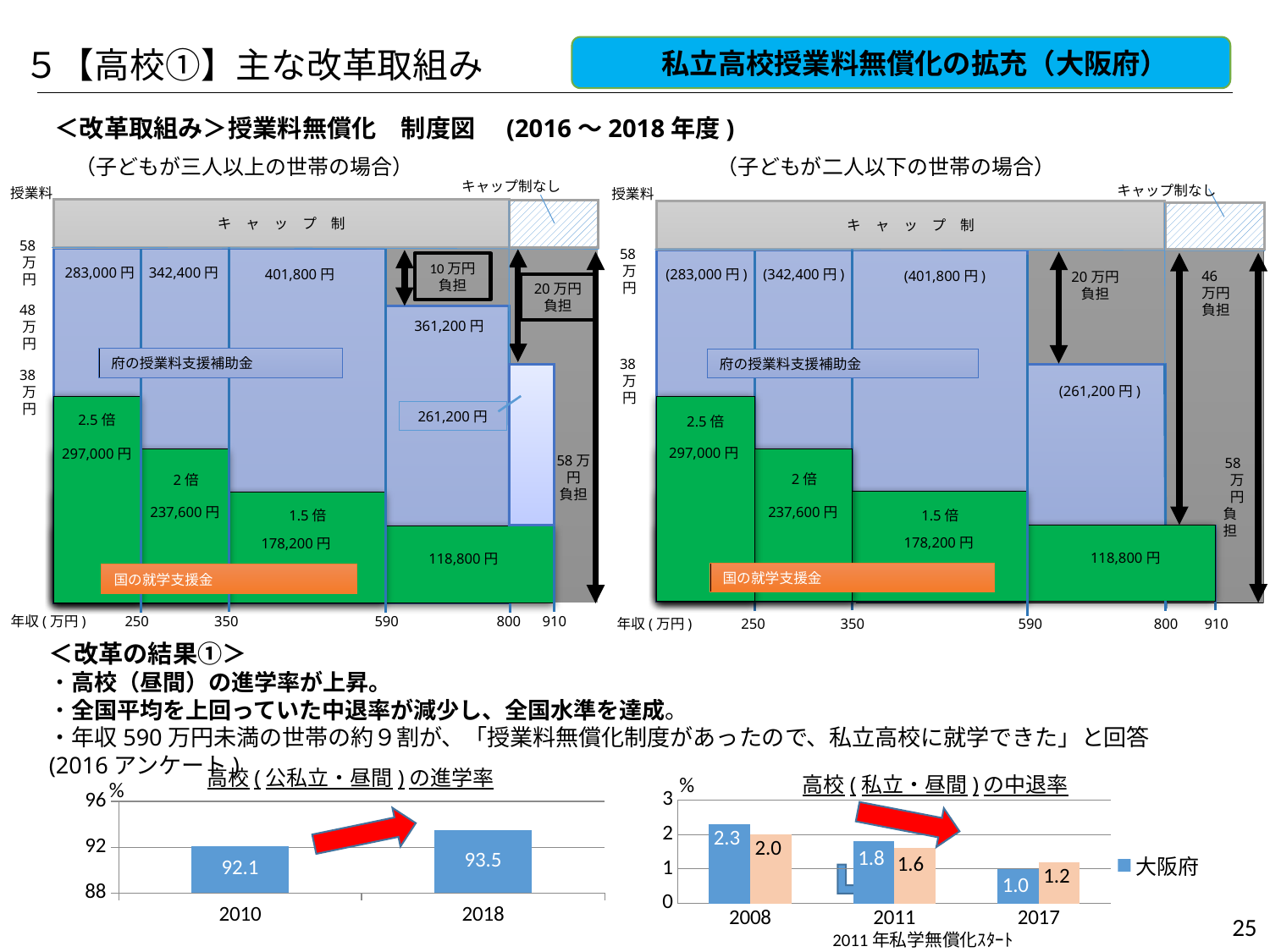
In the 高校(公私立・昼間)の進学率 chart, what is the difference between the 2018 and 2010 values? 1.4 What kind of chart is the 高校(私立・昼間)の中退率 chart? bar chart In the 高校(公私立・昼間)の進学率 chart, what is the value for 2010? 92.1 In the 高校(私立・昼間)の中退率 chart, what is the 大阪府 value for 2008? 2.3 In the 高校(公私立・昼間)の進学率 chart, what is the value for 2018? 93.5 In the 高校(私立・昼間)の中退率 chart, what is the difference between the 大阪府 values for 2008 and 2017? 1.3 In the 高校(私立・昼間)の中退率 chart, how many years are shown on the x axis? 3 In the 高校(私立・昼間)の中退率 chart, what is the 大阪府 value for 2017? 1.0 In the 高校(公私立・昼間)の進学率 chart, how many years are plotted? 2 In the 高校(公私立・昼間)の進学率 chart, do the values rise or fall from 2010 to 2018? rise In the 高校(私立・昼間)の中退率 chart, which is larger in 2017: the 大阪府 bar (1.0) or the other bar (1.2)? the other bar (1.2) In the 高校(私立・昼間)の中退率 chart, which year has the highest 大阪府 value? 2008